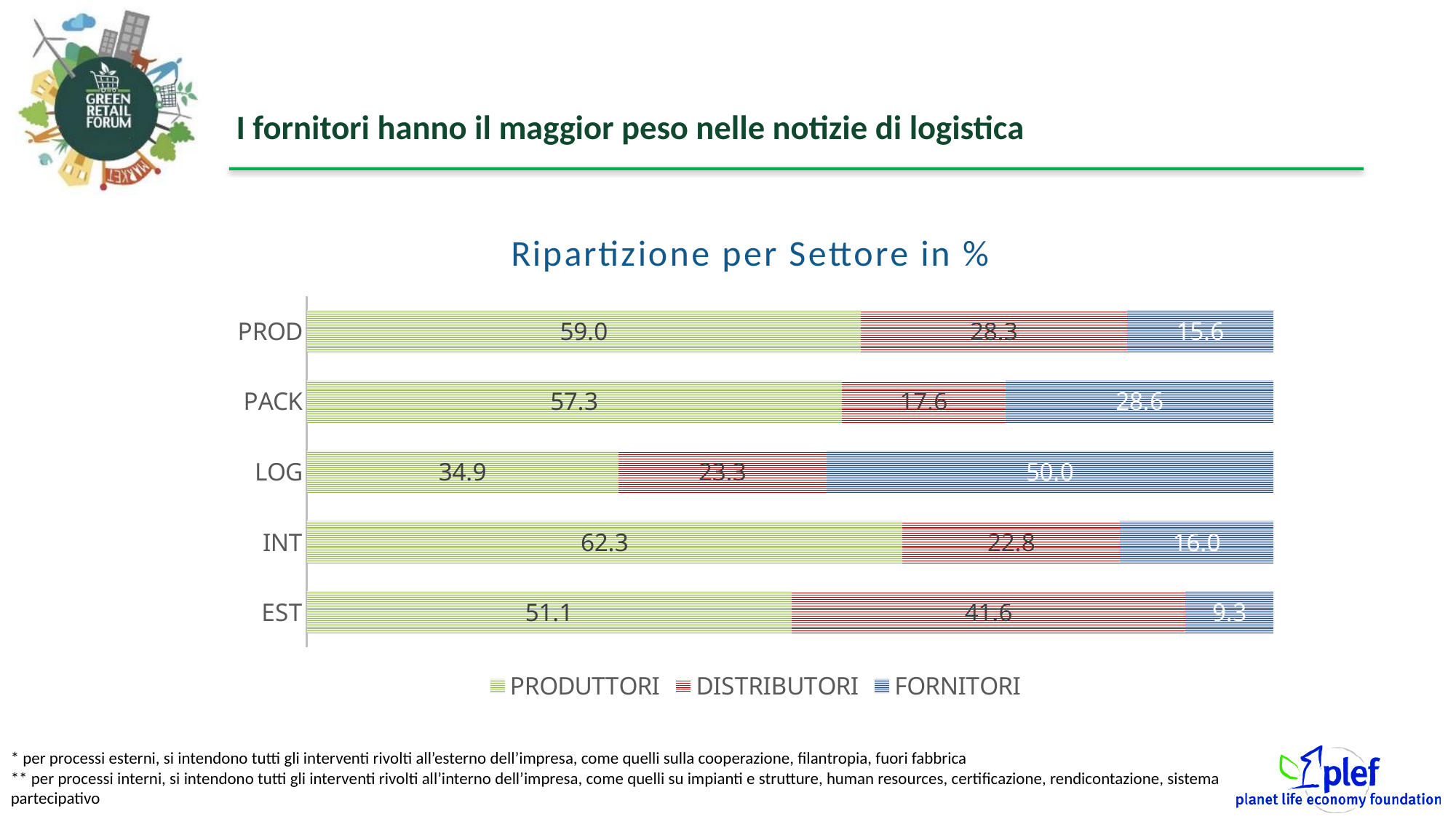
How many categories are shown on the chart? 5 Which category has the highest FORNITORI value? LOG Which category has the highest PRODUTTORI value? INT What is the FORNITORI value for PACK? 28.6 Which category has the lowest FORNITORI value? EST Which is larger, the PRODUTTORI value for PROD or for PACK? PROD What is the PRODUTTORI value for LOG? 34.9 What is the DISTRIBUTORI value for EST? 41.6 How many series does the legend list? 3 What is the difference between the DISTRIBUTORI values for EST and PACK? 24.0 What is the title of the chart? Ripartizione per Settore in % What kind of chart is shown on the slide? Stacked bar chart